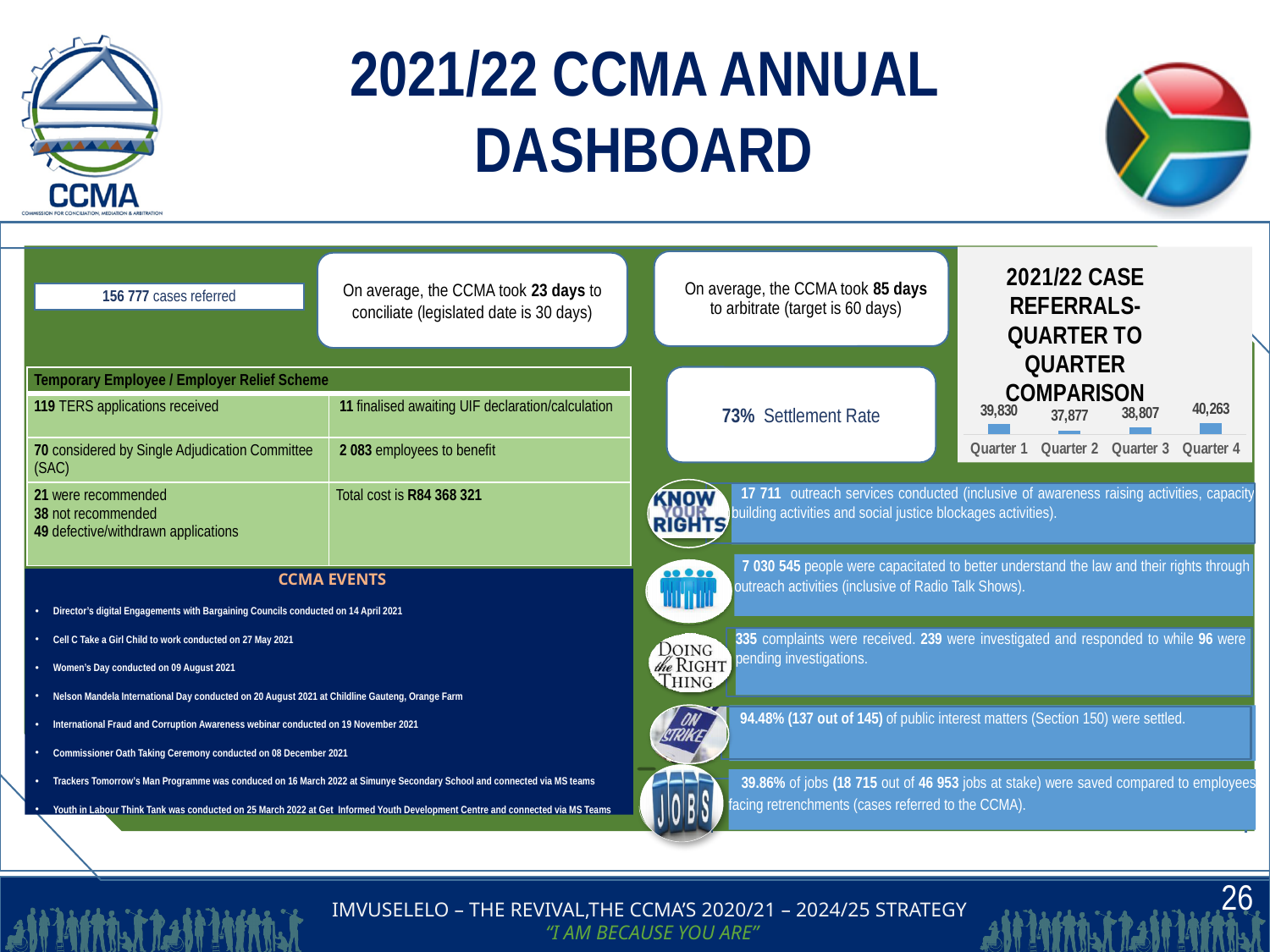
What type of chart is used for the 2021/22 case referrals quarter to quarter comparison? Bar chart What is the difference between the Quarter 4 and Quarter 2 values in the case referrals chart? 2,386 Which quarter has the lowest number of case referrals in the chart? Quarter 2 What is the value for Quarter 3 in the case referrals chart? 38,807 What is the value for Quarter 4 in the case referrals chart? 40,263 What is the value for Quarter 1 in the case referrals chart? 39,830 What is the value for Quarter 2 in the case referrals chart? 37,877 What is the difference between the Quarter 1 and Quarter 3 values in the case referrals chart? 1,023 Which quarter has the highest number of case referrals in the chart? Quarter 4 In the case referrals chart, which is larger: Quarter 1 or Quarter 3? Quarter 1 How many quarters are shown in the case referrals chart? 4 What is the title of the chart on the slide? 2021/22 CASE REFERRALS- QUARTER TO QUARTER COMPARISON